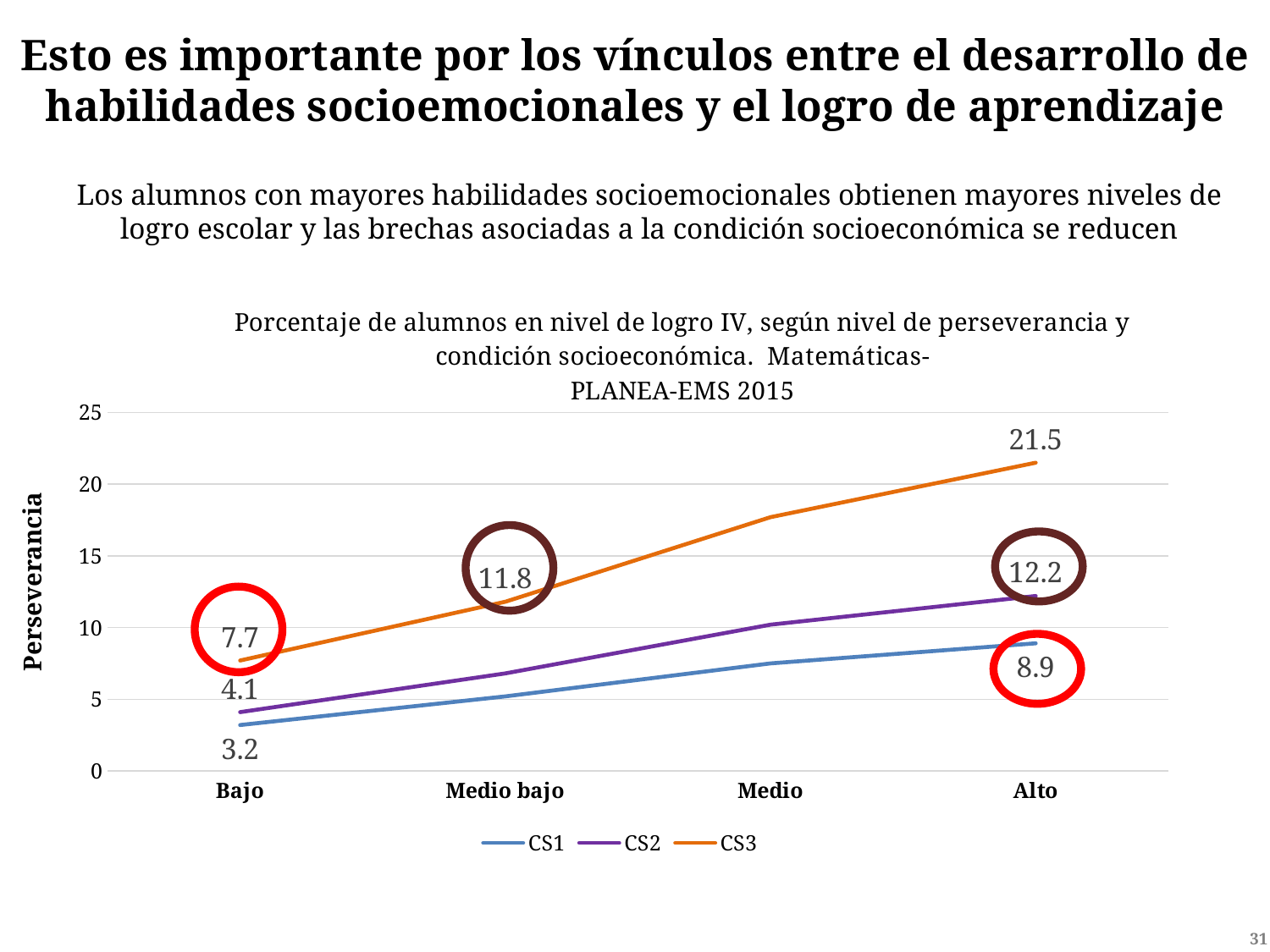
How many categories are shown on the x axis? 4 What type of chart is shown on the slide? line chart What is the value for CS1 at the Alto level? 8.9 How many series does the legend list? 3 Is the value for CS3 at the Medio level greater or less than 15? greater Do the CS2 values rise or fall from Bajo to Alto? rise Which series has the lowest value at the Bajo level? CS1 What is the value for CS3 at the Medio bajo level? 11.8 What is the value for CS3 at the Bajo level? 7.7 What is the difference between the CS3 value at Alto and the CS3 value at Bajo? 13.8 What is the value for CS2 at the Bajo level? 4.1 Which series has the highest value at the Alto level? CS3